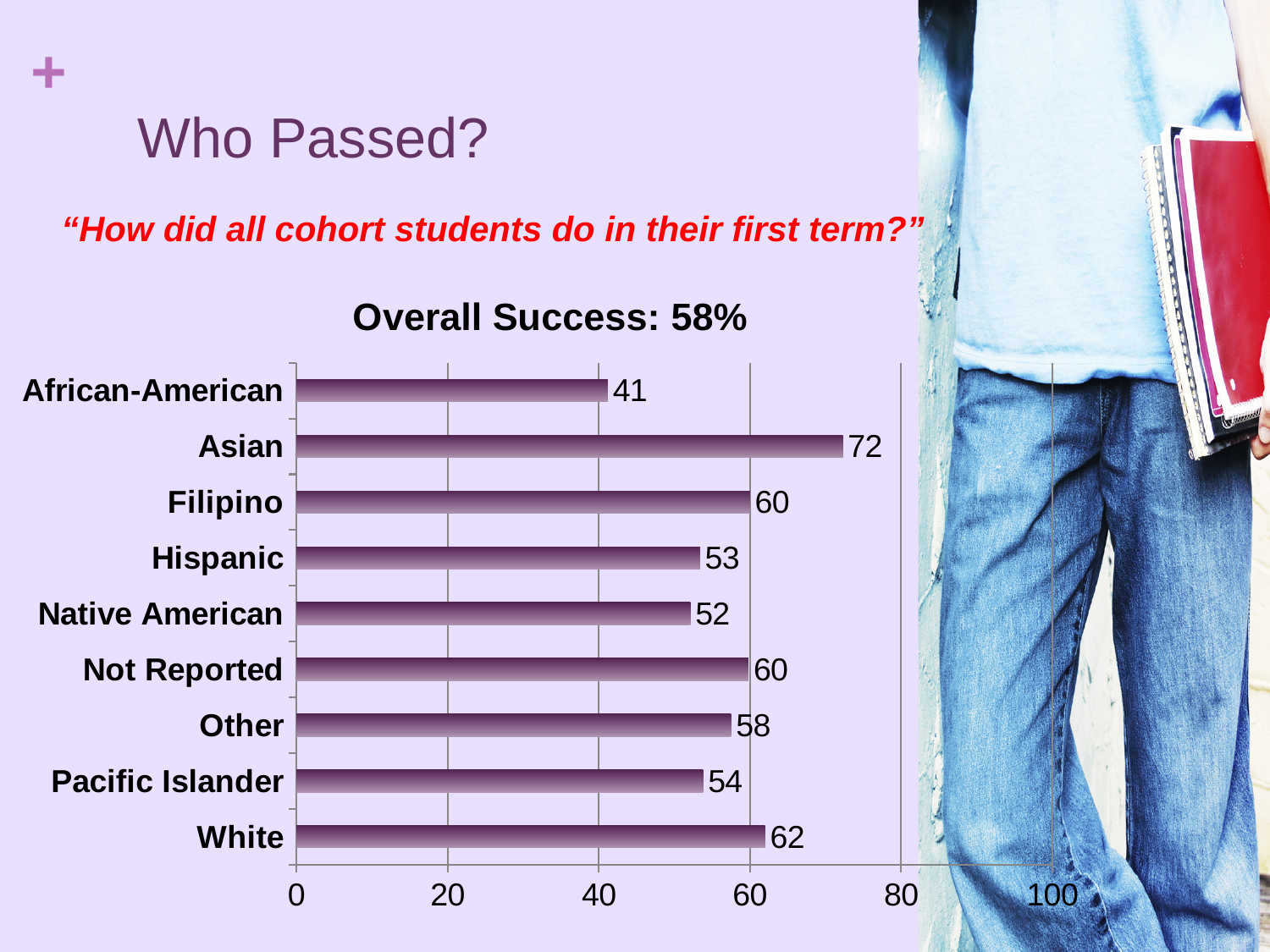
What is the value for African-American? 41 Which category has the lowest value? African-American Is the value for Native American greater or less than 60? less What is the difference between the values for White and Hispanic? 9 What is the value for Pacific Islander? 54 What kind of chart is shown on the slide? bar chart Which category has the highest value? Asian What is the value for Asian? 72 What is the title of the chart? Overall Success: 58% What is the difference between the values for Asian and African-American? 31 Which is larger, the value for Filipino or the value for Other? Filipino How many categories are shown in the chart? 9